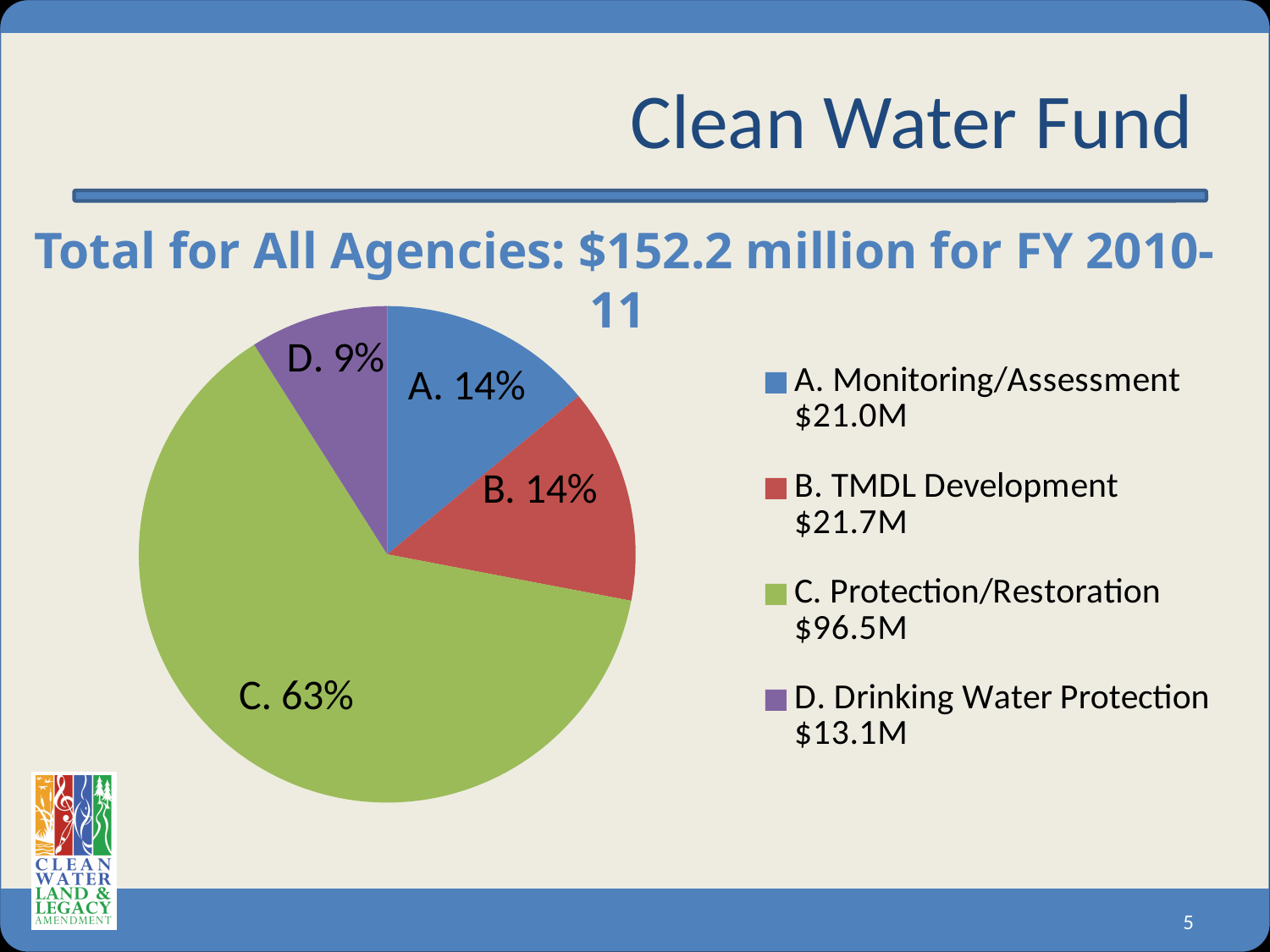
What share of the pie does A. Monitoring/Assessment represent? 14% How many slices does the pie chart have? 4 What dollar amount is listed in the legend for C. Protection/Restoration? $96.5M What is the difference in dollar amount between C. Protection/Restoration and A. Monitoring/Assessment? $75.5M What kind of chart is shown on the slide? pie chart Which category has the smallest slice of the pie? D. Drinking Water Protection Which category has the largest slice of the pie? C. Protection/Restoration What share of the pie does C. Protection/Restoration represent? 63% What share of the pie does D. Drinking Water Protection represent? 9% What colour is the slice for B. TMDL Development? red What dollar amount is listed in the legend for D. Drinking Water Protection? $13.1M What dollar amount is listed in the legend for B. TMDL Development? $21.7M